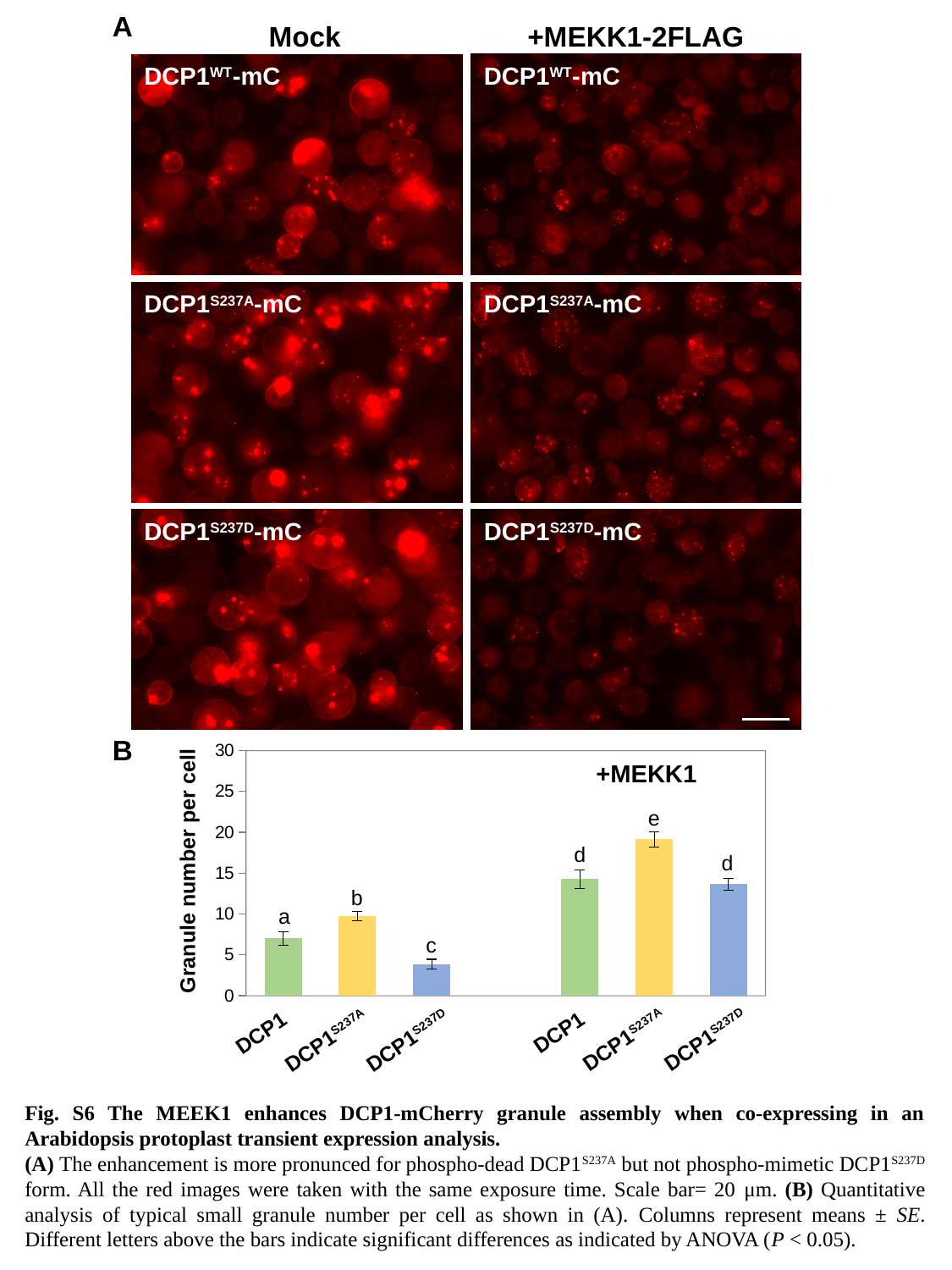
In the panel B chart, what letter appears above the DCP1S237A bar in the +MEKK1 group? e In the panel B chart, which bar is the lowest? DCP1S237D in the group without MEKK1 In the panel B chart, is the value for DCP1S237D in the group without MEKK1 greater or less than 5? less What is the y-axis label of the panel B chart? Granule number per cell In the panel B chart, is the value for DCP1S237A in the +MEKK1 group greater or less than 15? greater In the panel B chart, which bar is the highest? DCP1S237A in the +MEKK1 group What kind of chart is shown in panel B? bar chart In the panel B chart, which is larger: the value for DCP1S237D without MEKK1 or the value for DCP1S237D with +MEKK1? DCP1S237D with +MEKK1 In the panel B chart, how many bars are plotted in total? 6 In the panel B chart, which is larger in the group without MEKK1: the value for DCP1 or the value for DCP1S237A? DCP1S237A In the panel B chart, is the value for DCP1 in the group without MEKK1 greater or less than 10? less